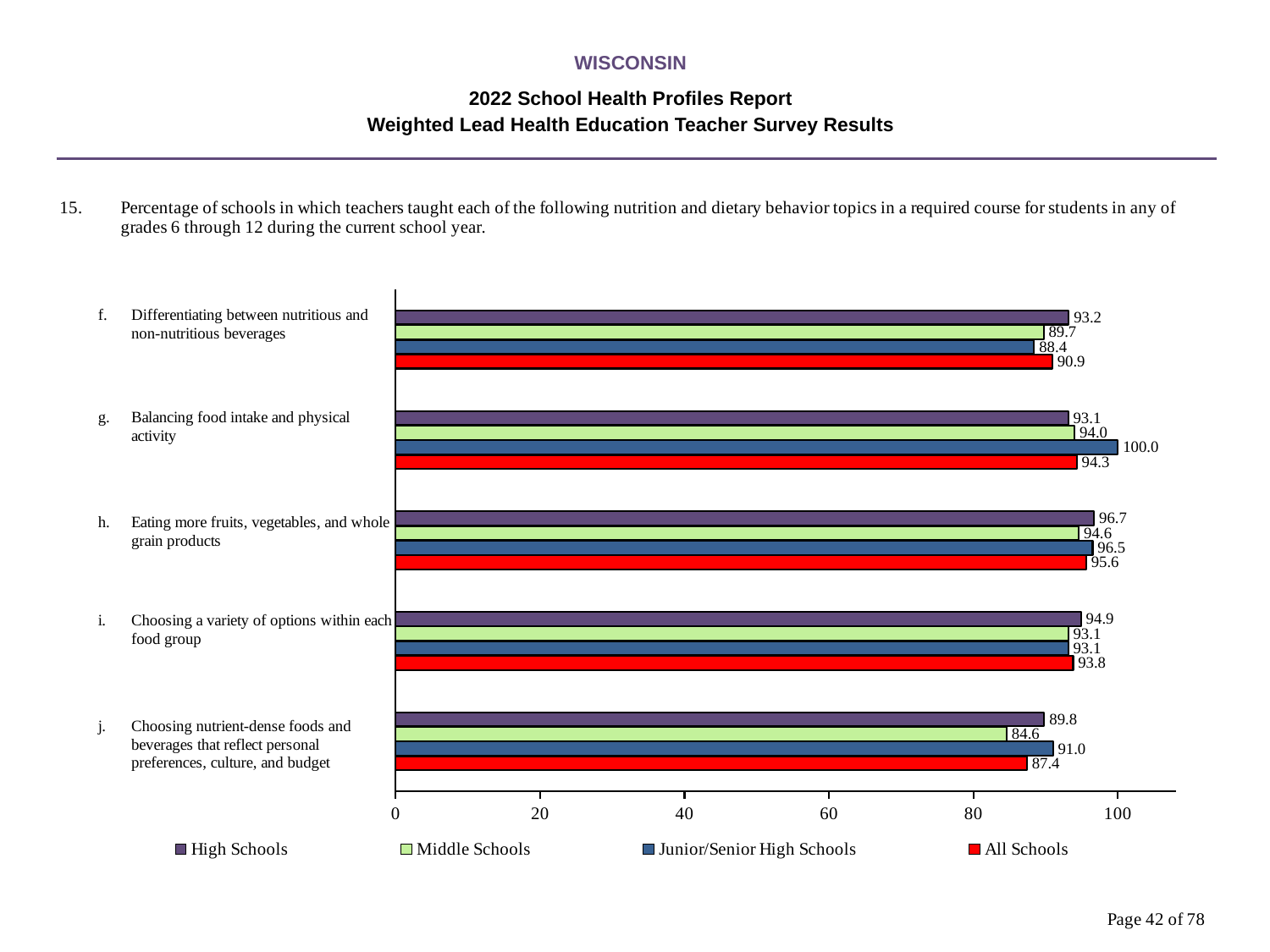
Which topic has the lowest Middle Schools value? j. Choosing nutrient-dense foods and beverages that reflect personal preferences, culture, and budget What is the difference between the Junior/Senior High Schools value and the Middle Schools value for topic j? 6.4 What is the value for High Schools for topic f, differentiating between nutritious and non-nutritious beverages? 93.2 How many nutrition and dietary behavior topics are shown on the chart? 5 Which colour represents All Schools in the legend? Red Which topic has the highest All Schools value? h. Eating more fruits, vegetables, and whole grain products What is the All Schools value for topic j, choosing nutrient-dense foods and beverages that reflect personal preferences, culture, and budget? 87.4 For topic f, which is larger: the High Schools value or the Junior/Senior High Schools value? High Schools What is the Middle Schools value for topic h, eating more fruits, vegetables, and whole grain products? 94.6 What kind of chart is shown on the slide? Bar chart What is the value for Junior/Senior High Schools for topic g, balancing food intake and physical activity? 100.0 How many series does the legend list? 4